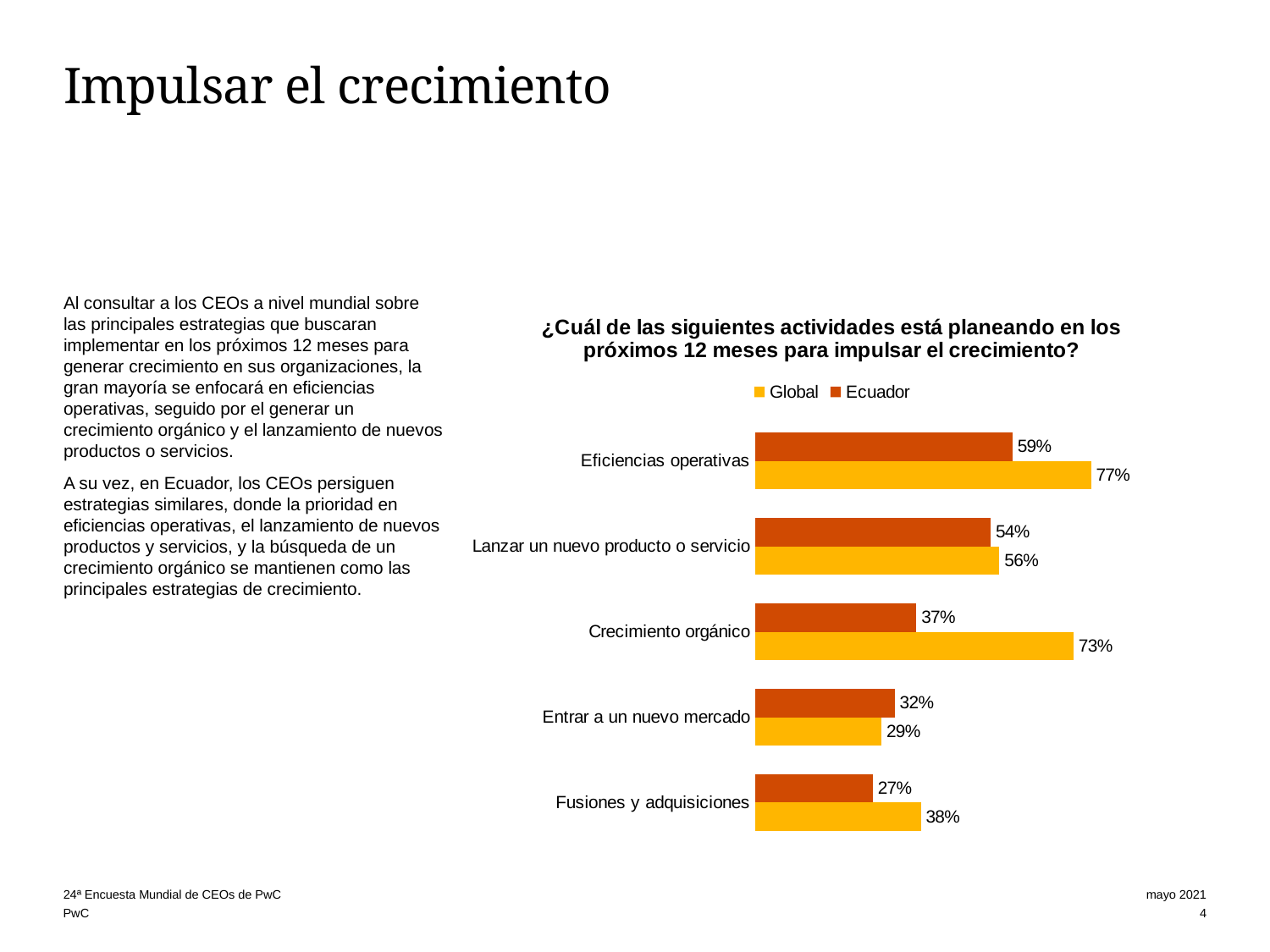
Which category has the highest Global value? Eficiencias operativas For Entrar a un nuevo mercado, which is larger: the Global value or the Ecuador value? Ecuador Which category has the lowest Ecuador value? Fusiones y adquisiciones What is the difference between the Global and Ecuador values for Eficiencias operativas? 18% What is the difference between the Global and Ecuador values for Crecimiento orgánico? 36% What is the Global value for Fusiones y adquisiciones? 38% What is the Global value for Eficiencias operativas? 77% What is the Ecuador value for Crecimiento orgánico? 37% What kind of chart is shown on the slide? Bar chart How many series does the legend list? 2 How many categories are shown in the chart? 5 What is the Ecuador value for Entrar a un nuevo mercado? 32%